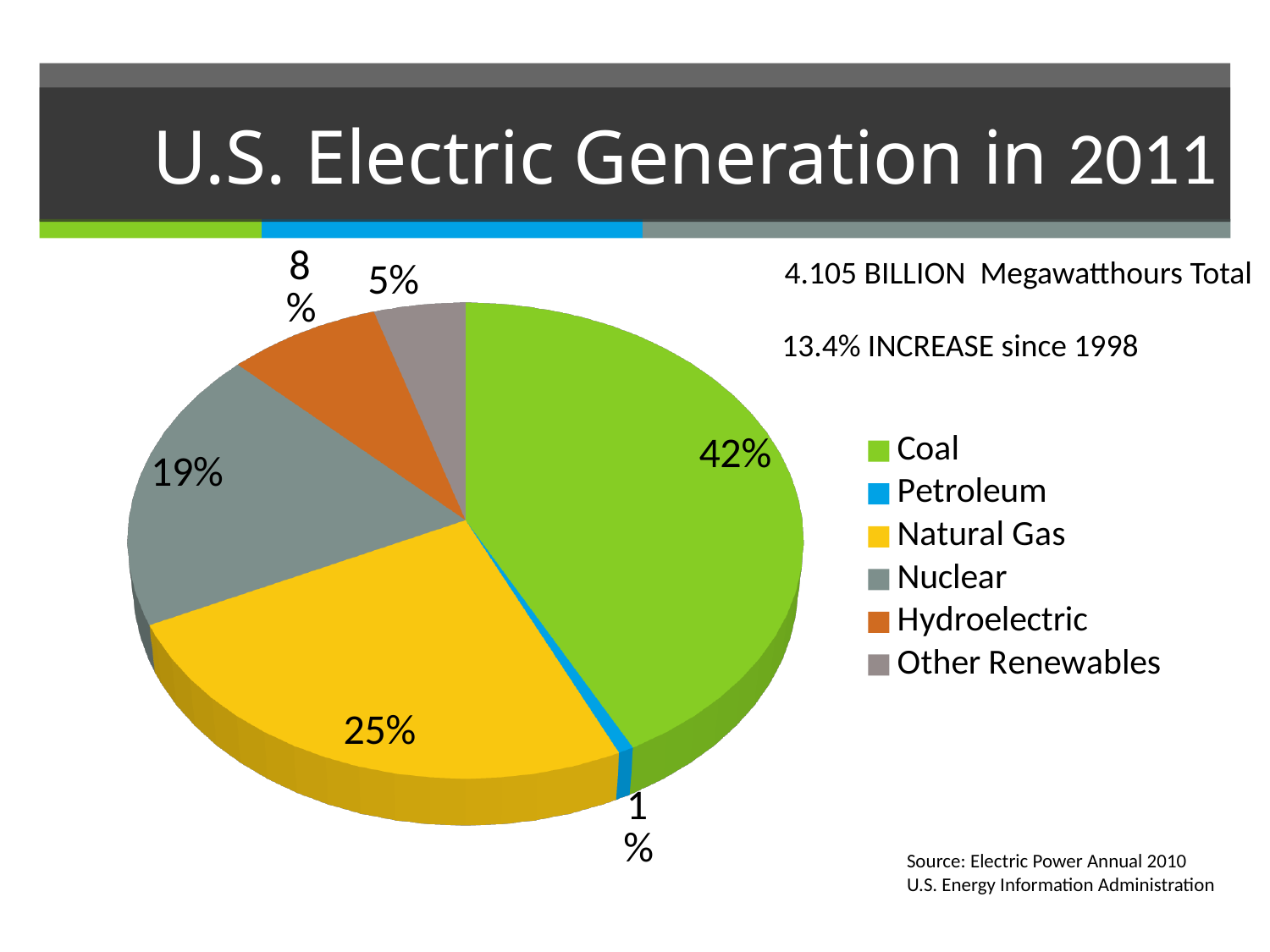
What share of U.S. electric generation in 2011 came from Natural Gas? 25% How many energy sources does the legend list? 6 What share of U.S. electric generation in 2011 came from Hydroelectric? 8% What share of U.S. electric generation in 2011 came from Coal? 42% Which energy source has the largest share of the pie? Coal What share of U.S. electric generation in 2011 came from Nuclear? 19% How many percentage points larger is the Coal share than the Natural Gas share? 17 What share of U.S. electric generation in 2011 came from Petroleum? 1% Which has a larger share, Nuclear or Hydroelectric? Nuclear Which energy source has the smallest share of the pie? Petroleum What kind of chart is shown on the slide? Pie chart What share of U.S. electric generation in 2011 came from Other Renewables? 5%